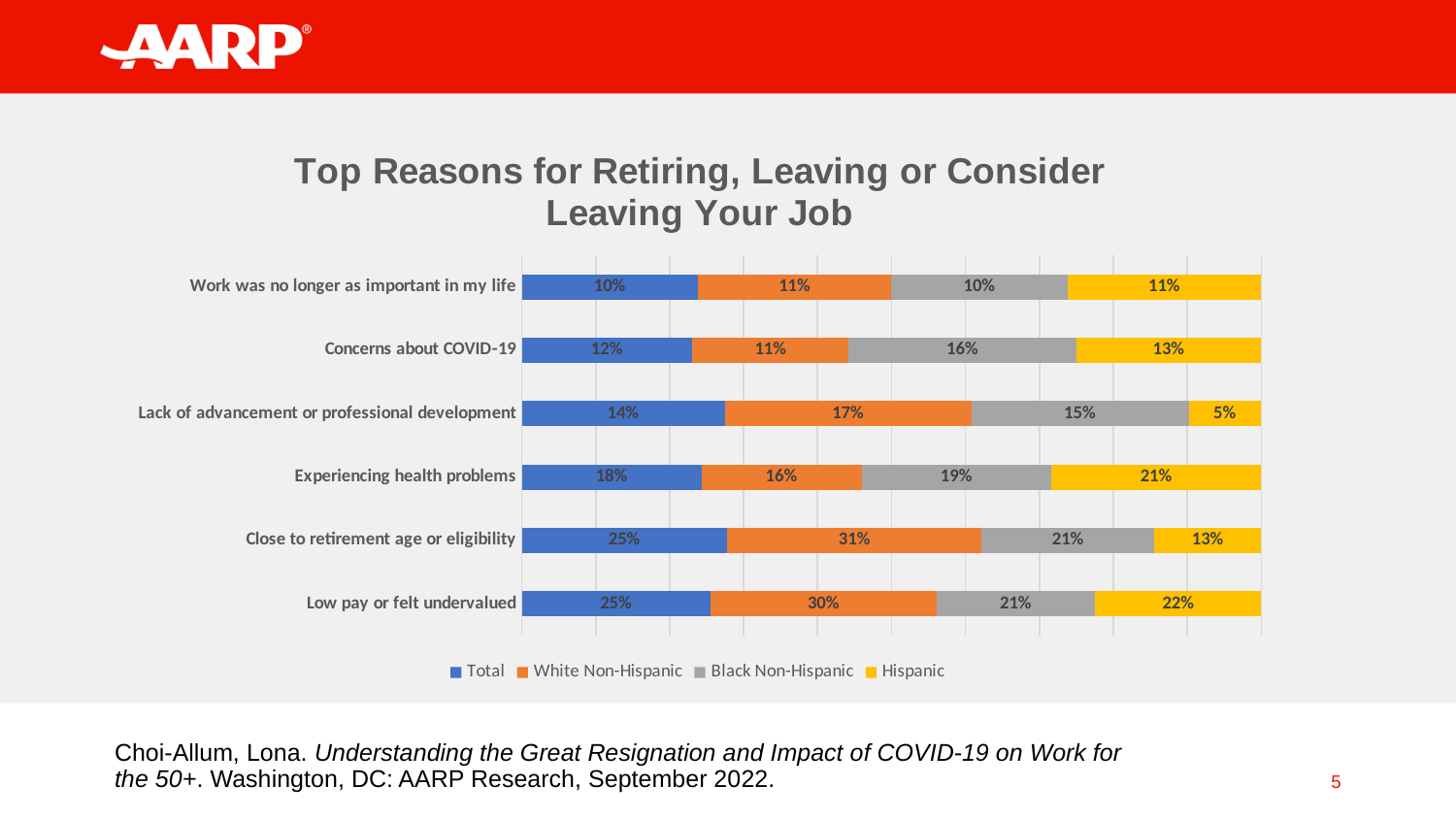
What is the White Non-Hispanic value for "Close to retirement age or eligibility"? 31% What is the Hispanic value for "Experiencing health problems"? 21% What is the Black Non-Hispanic value for "Concerns about COVID-19"? 16% Which reason has the highest Hispanic value? Low pay or felt undervalued How many series does the legend list? 4 For "Concerns about COVID-19", which is larger: the Black Non-Hispanic value or the Total value? Black Non-Hispanic What is the total of the stacked bar for "Low pay or felt undervalued"? 98% What is the difference between the White Non-Hispanic and Hispanic values for "Close to retirement age or eligibility"? 18 percentage points Which reason has the highest White Non-Hispanic value? Close to retirement age or eligibility How many reasons (categories) are shown in the chart? 6 Which reason has the lowest Hispanic value? Lack of advancement or professional development What kind of chart is shown on the slide? Stacked bar chart